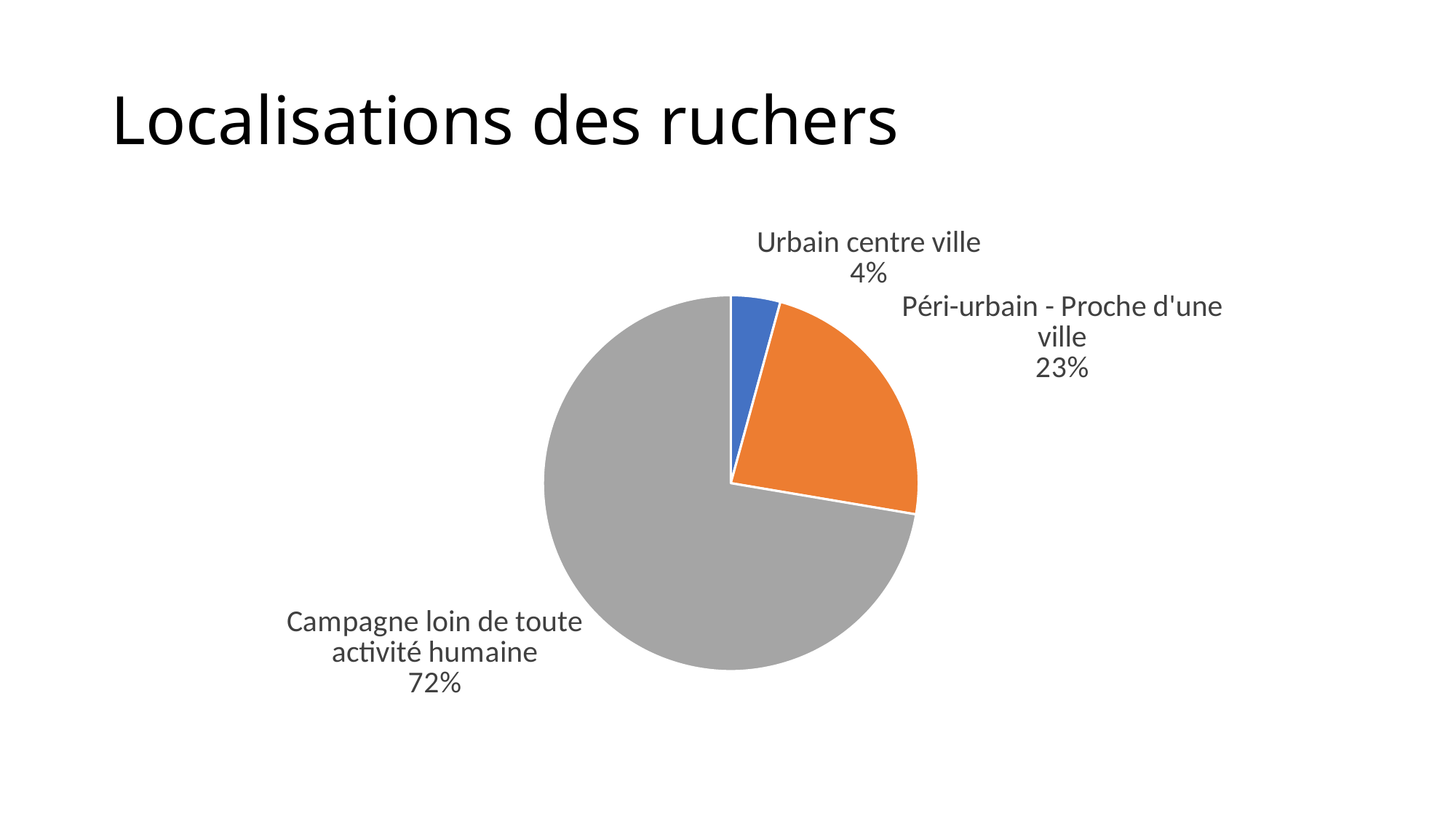
What share of the pie does "Urbain centre ville" represent? 4% What kind of chart is shown on the slide? Pie chart How many categories are shown in the pie chart? 3 What is the difference in percentage points between "Péri-urbain - Proche d'une ville" and "Urbain centre ville"? 19 percentage points What share of the pie does "Campagne loin de toute activité humaine" represent? 72% What share of the pie does "Péri-urbain - Proche d'une ville" represent? 23% What is the difference in percentage points between "Campagne loin de toute activité humaine" and "Péri-urbain - Proche d'une ville"? 49 percentage points Which category has the largest slice of the pie? Campagne loin de toute activité humaine Which is larger: the share for "Péri-urbain - Proche d'une ville" or the share for "Urbain centre ville"? Péri-urbain - Proche d'une ville What colour is the slice for "Urbain centre ville"? Blue What is the title of the slide? Localisations des ruchers Which category has the smallest slice of the pie? Urbain centre ville